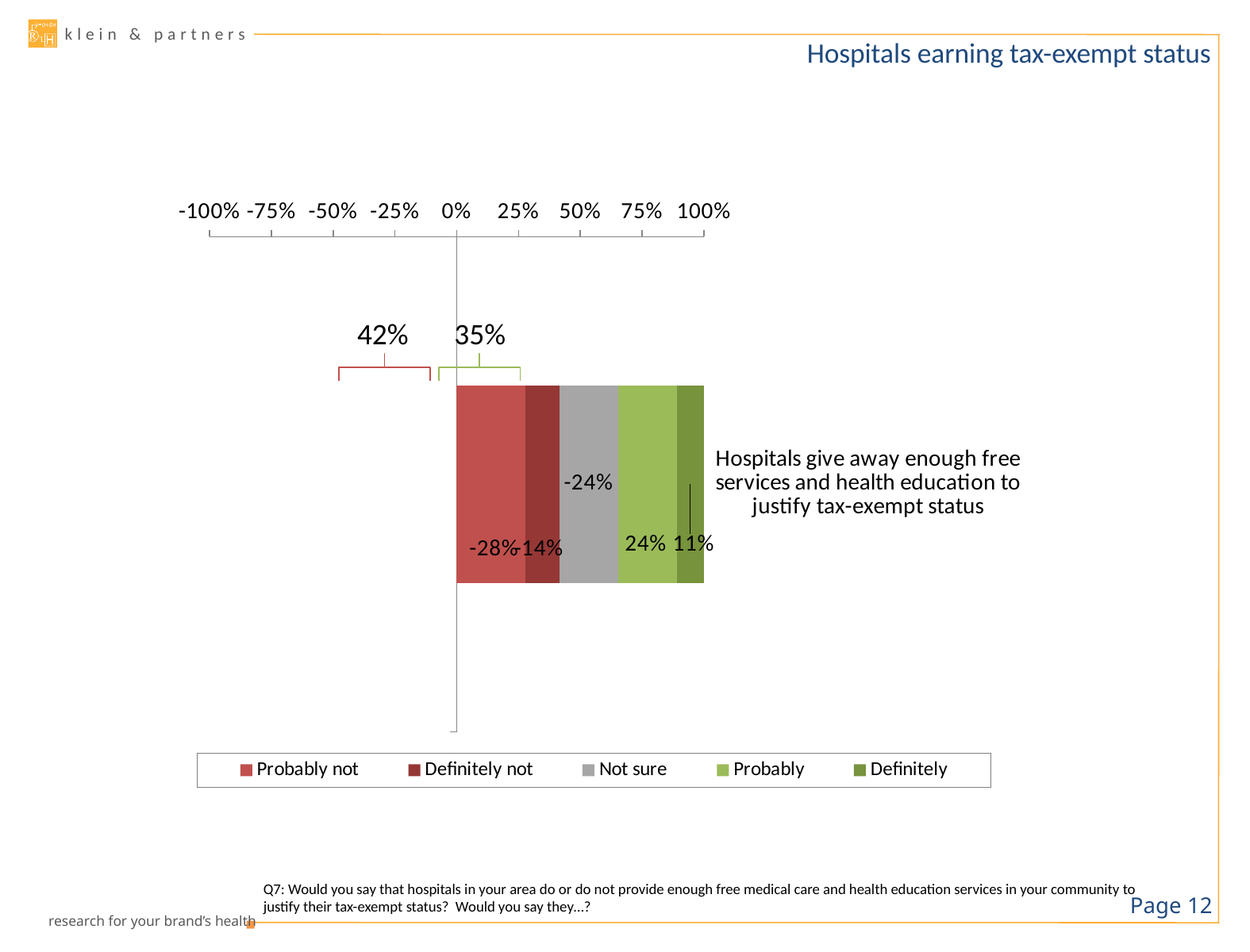
What is the data label shown on the 'Not sure' segment? -24% Which series has the smallest segment in the bar? Definitely How many series does the legend list? 5 What is the data label for the 'Definitely not' segment? -14% What combined percentage is shown above the positive (green) segments? 35% What is the data label for the 'Probably' segment? 24% What is the title of the slide? Hospitals earning tax-exempt status What is the data label for the 'Definitely' segment? 11% What is the data label for the 'Probably not' segment? -28% What type of chart is shown on the slide? Stacked bar chart Which series has the largest segment in the bar? Probably not What combined percentage is shown above the negative (red) segments? 42%